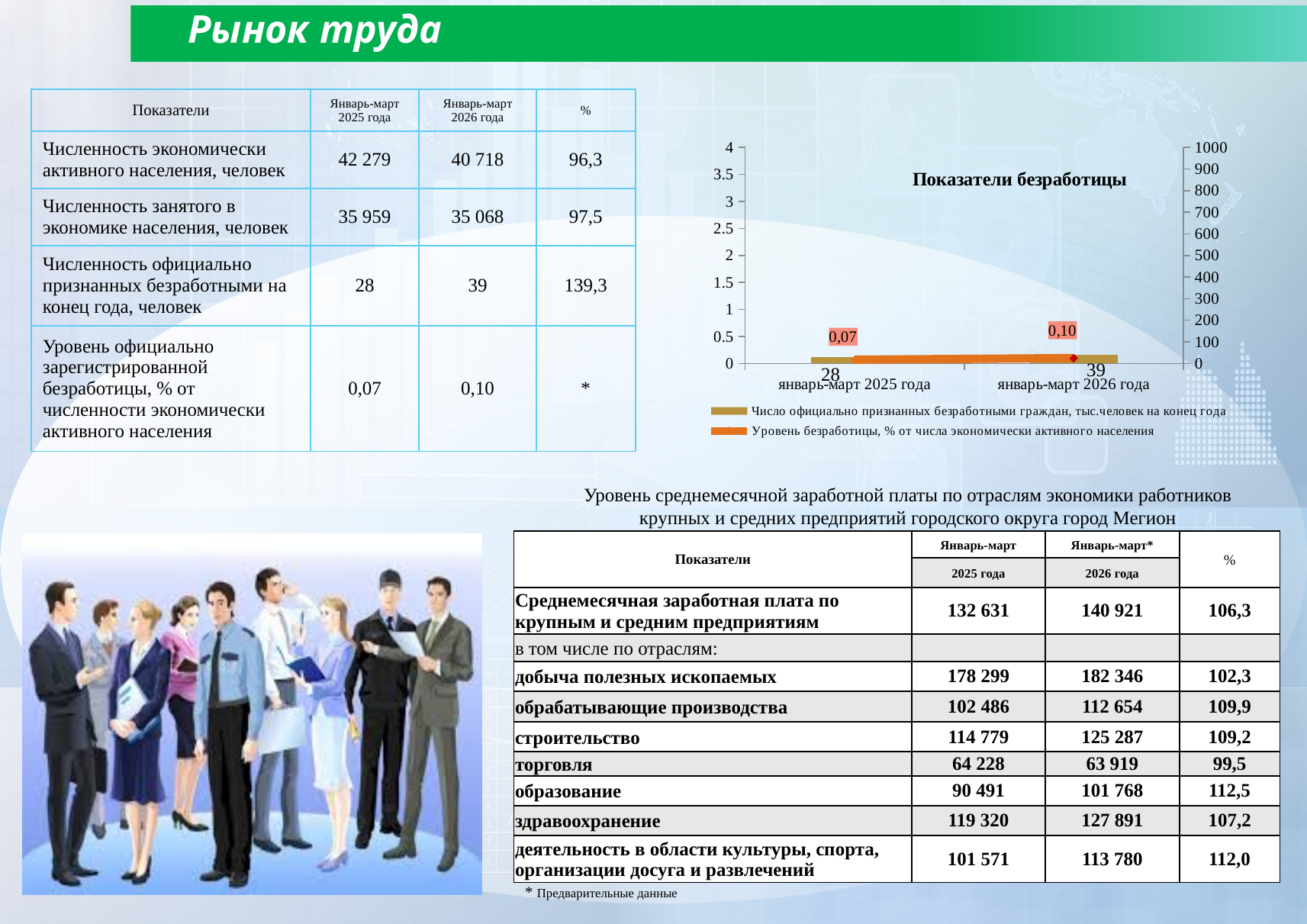
What kind of chart is 'Показатели безработицы'? combination bar and line chart In the chart 'Показатели безработицы', does the number of officially recognised unemployed citizens rise or fall from январь-март 2025 года to январь-март 2026 года? rise In the chart 'Показатели безработицы', what is the unemployment rate (% of economically active population) for январь-март 2026 года? 0,10 In the chart 'Показатели безработицы', which period has the higher number of officially recognised unemployed citizens? январь-март 2026 года In the chart 'Показатели безработицы', what is the number of officially recognised unemployed citizens for январь-март 2026 года? 39 In the chart 'Показатели безработицы', what is the unemployment rate (% of economically active population) for январь-март 2025 года? 0,07 In the chart 'Показатели безработицы', what is the difference between the unemployment rates for январь-март 2026 года and январь-март 2025 года? 0,03 In the chart 'Показатели безработицы', which period has the highest unemployment rate? январь-март 2026 года In the chart 'Показатели безработицы', by how much did the number of officially recognised unemployed citizens change from январь-март 2025 года to январь-март 2026 года? 11 How many series does the legend of the chart 'Показатели безработицы' list? 2 In the chart 'Показатели безработицы', what is the number of officially recognised unemployed citizens for январь-март 2025 года? 28 How many periods (categories) are shown on the x axis of the chart 'Показатели безработицы'? 2